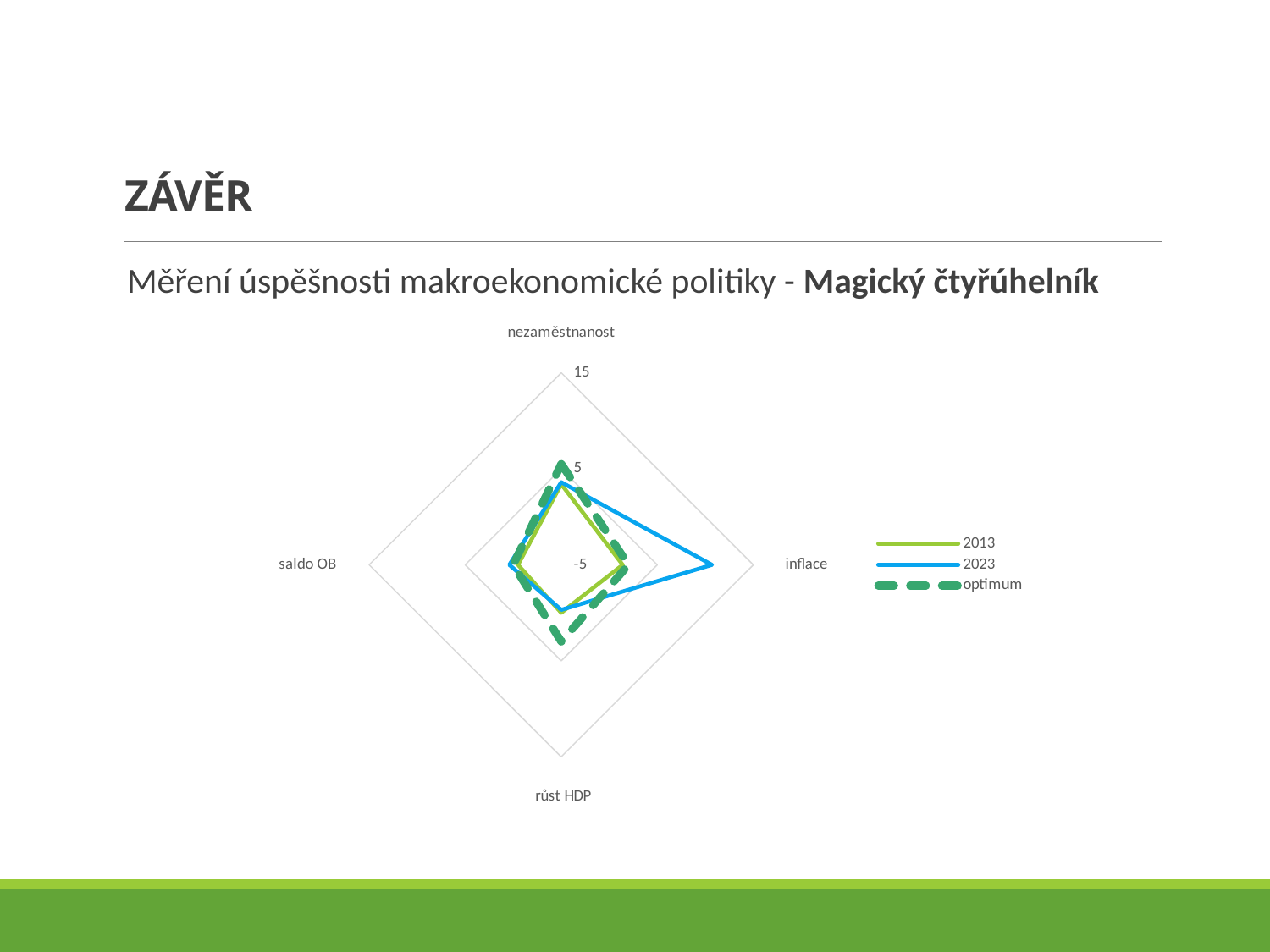
Which series has the larger value on the inflace axis, 2013 or 2023? 2023 Which series is drawn with a dashed line? optimum How many series does the legend list? 3 What is the highest value shown on the radar chart's axis scale? 15 What kind of chart is shown on the slide? radar chart What are the three series listed in the legend? 2013, 2023, optimum Which series reaches the highest value on the inflace axis? 2023 Is the 2023 value on the inflace axis greater or less than 5? greater How many axes (categories) does the radar chart have? 4 Is the 2023 value on the inflace axis greater or less than 15? less